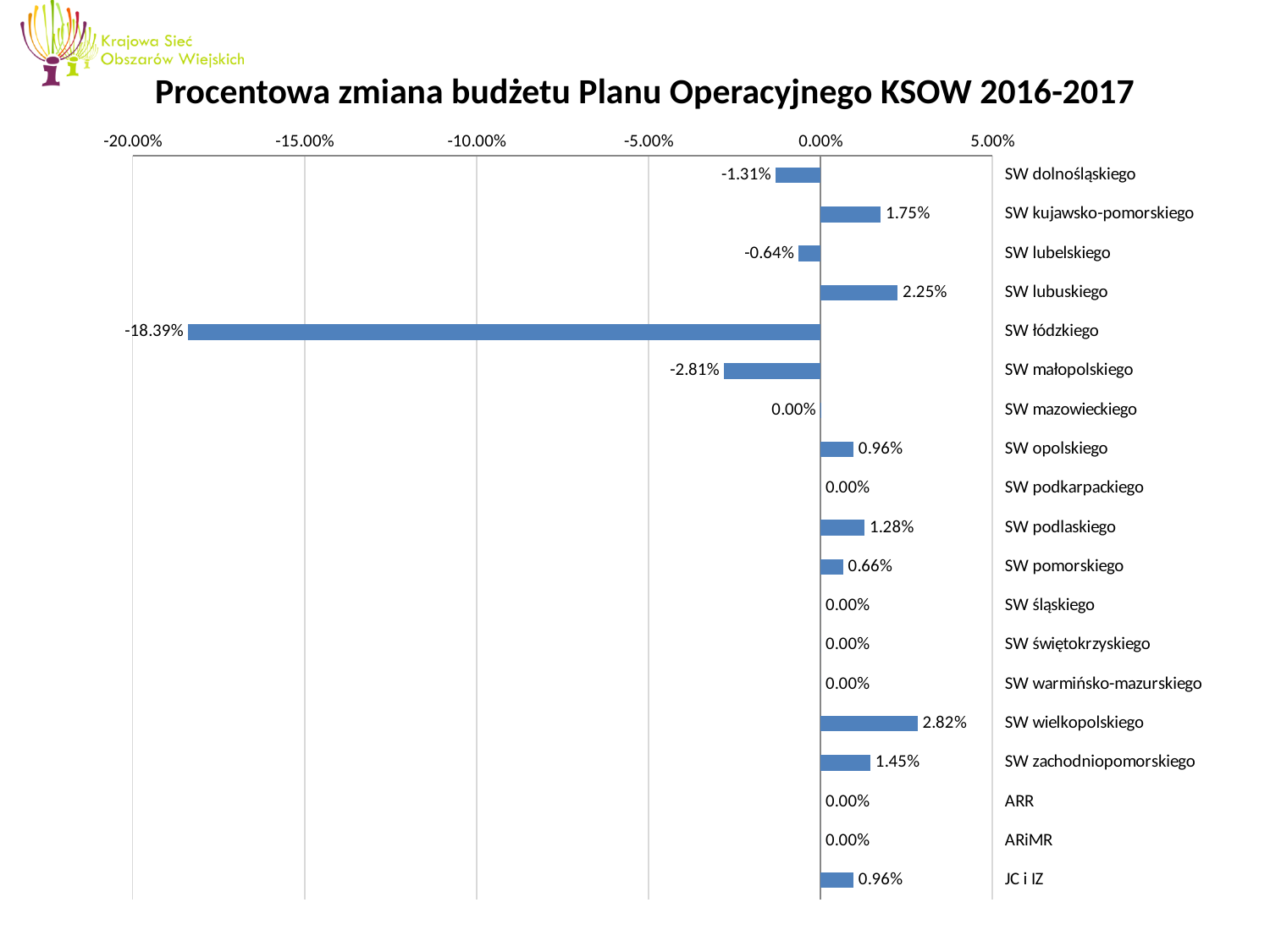
What is the value for SW małopolskiego? -2.81% Which is larger, the value for SW podlaskiego or the value for SW zachodniopomorskiego? SW zachodniopomorskiego Which category has the highest value? SW wielkopolskiego What is the value for JC i IZ? 0.96% What kind of chart is shown on the slide? bar chart What is the value for SW wielkopolskiego? 2.82% Which category has the lowest value? SW łódzkiego How many categories are shown in the chart? 19 What is the difference between the values for SW lubuskiego and SW kujawsko-pomorskiego? 0.50% Is the value for SW łódzkiego greater or less than -15.00%? less What is the title of the chart? Procentowa zmiana budżetu Planu Operacyjnego KSOW 2016-2017 What is the value for SW łódzkiego? -18.39%